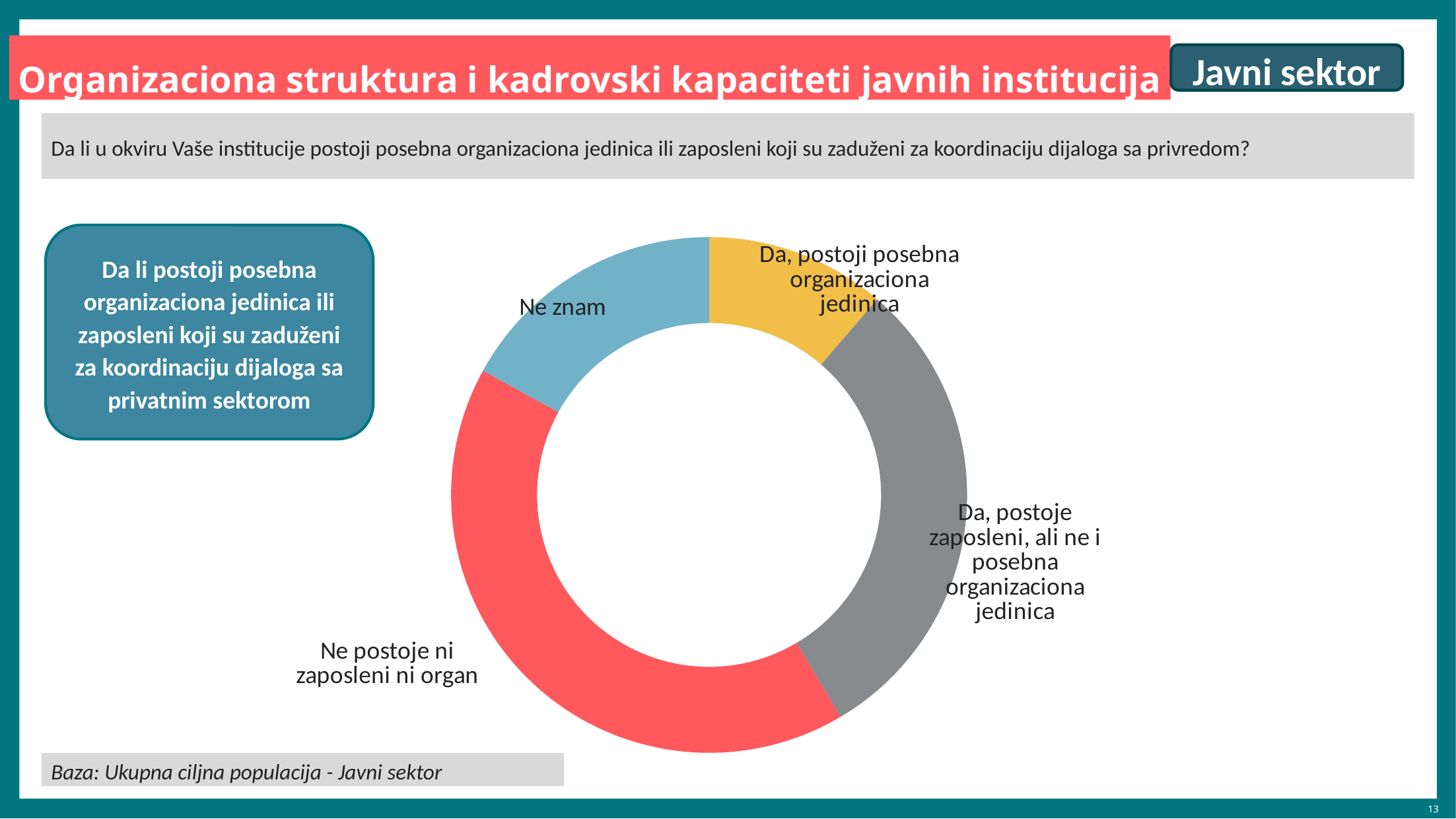
Which slice is larger: "Ne postoje ni zaposleni ni organ" or "Da, postoje zaposleni, ali ne i posebna organizaciona jedinica"? Ne postoje ni zaposleni ni organ Which category has the smallest slice in the donut chart? Da, postoji posebna organizaciona jedinica What colour is the slice for "Ne znam" in the donut chart? Light blue Which slice is larger: "Da, postoje zaposleni, ali ne i posebna organizaciona jedinica" or "Ne znam"? Da, postoje zaposleni, ali ne i posebna organizaciona jedinica What colour is the slice for "Ne postoje ni zaposleni ni organ" in the donut chart? Red Which category has the largest slice in the donut chart? Ne postoje ni zaposleni ni organ Which slice is larger: "Ne znam" or "Da, postoji posebna organizaciona jedinica"? Ne znam What kind of chart is shown on the slide? Donut (pie) chart How many categories (slices) does the donut chart have? 4